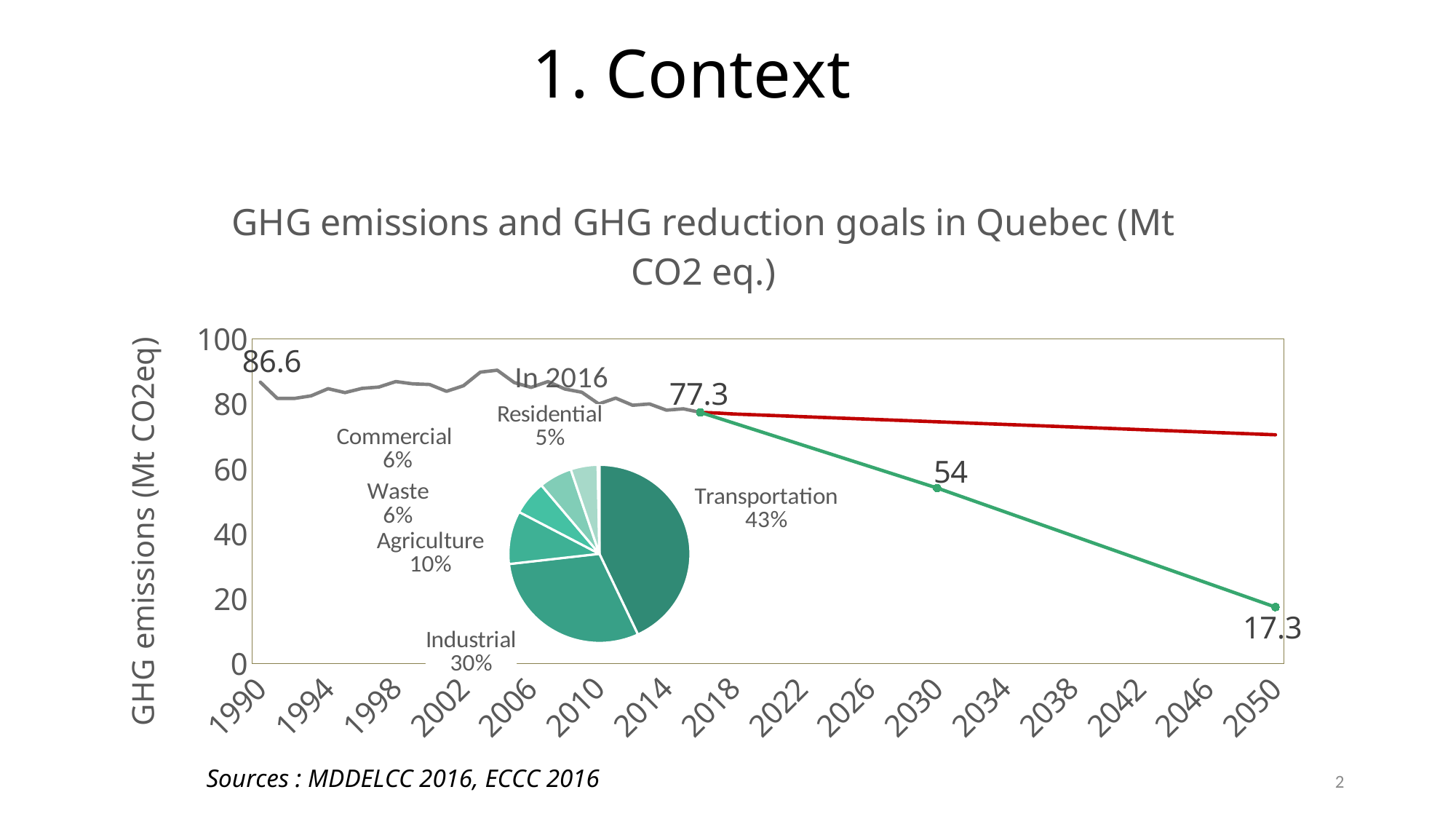
On the line chart, what is the reduction goal value labelled for 2030? 54 On the line chart, what is the GHG emissions value labelled for 1990? 86.6 On the line chart, is the red line's value at 2050 greater or less than 60? greater How many sectors are shown in the 'In 2016' pie chart? 6 On the line chart, what is the difference between the 2030 goal (54) and the 2050 goal (17.3)? 36.7 On the line chart, what is the GHG emissions value labelled at 2016? 77.3 In the 'In 2016' pie chart, which sector has the smallest share? Residential In the 'In 2016' pie chart, which sector has the largest share? Transportation On the line chart, what is the reduction goal value labelled for 2050? 17.3 On the line chart, what is the difference between the 1990 value (86.6) and the 2016 value (77.3)? 9.3 On the line chart, does the green goal line rise or fall from 2016 to 2050? fall In the 'In 2016' pie chart, what share does Industrial have? 30%